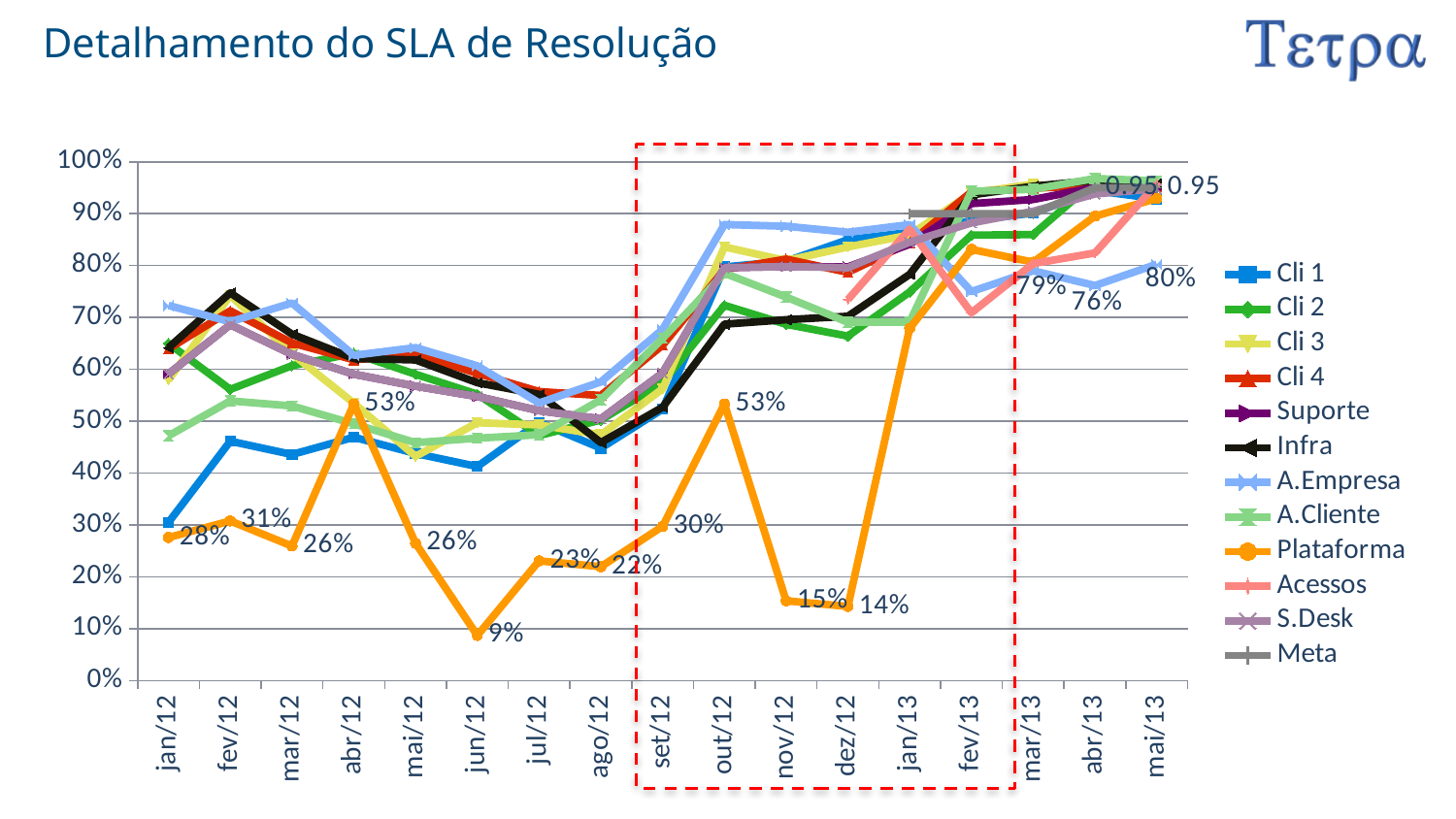
What is the difference between the Plataforma values in out/12 and nov/12? 38 percentage points In which month does Plataforma reach its lowest value? jun/12 Is the value for Cli 1 in jan/12 greater or less than 40%? less What type of chart is shown on the slide? line chart How many months are shown along the x axis? 17 What is the value for A.Empresa in mai/13? 80% Which is larger for Plataforma: the value in fev/12 or in mar/12? fev/12 Does the Plataforma line rise or fall from out/12 to dez/12? fall What is the value for Plataforma in out/12? 53% Which series is drawn in orange? Plataforma How many series does the legend list? 12 What is the value for Plataforma in jun/12? 9%